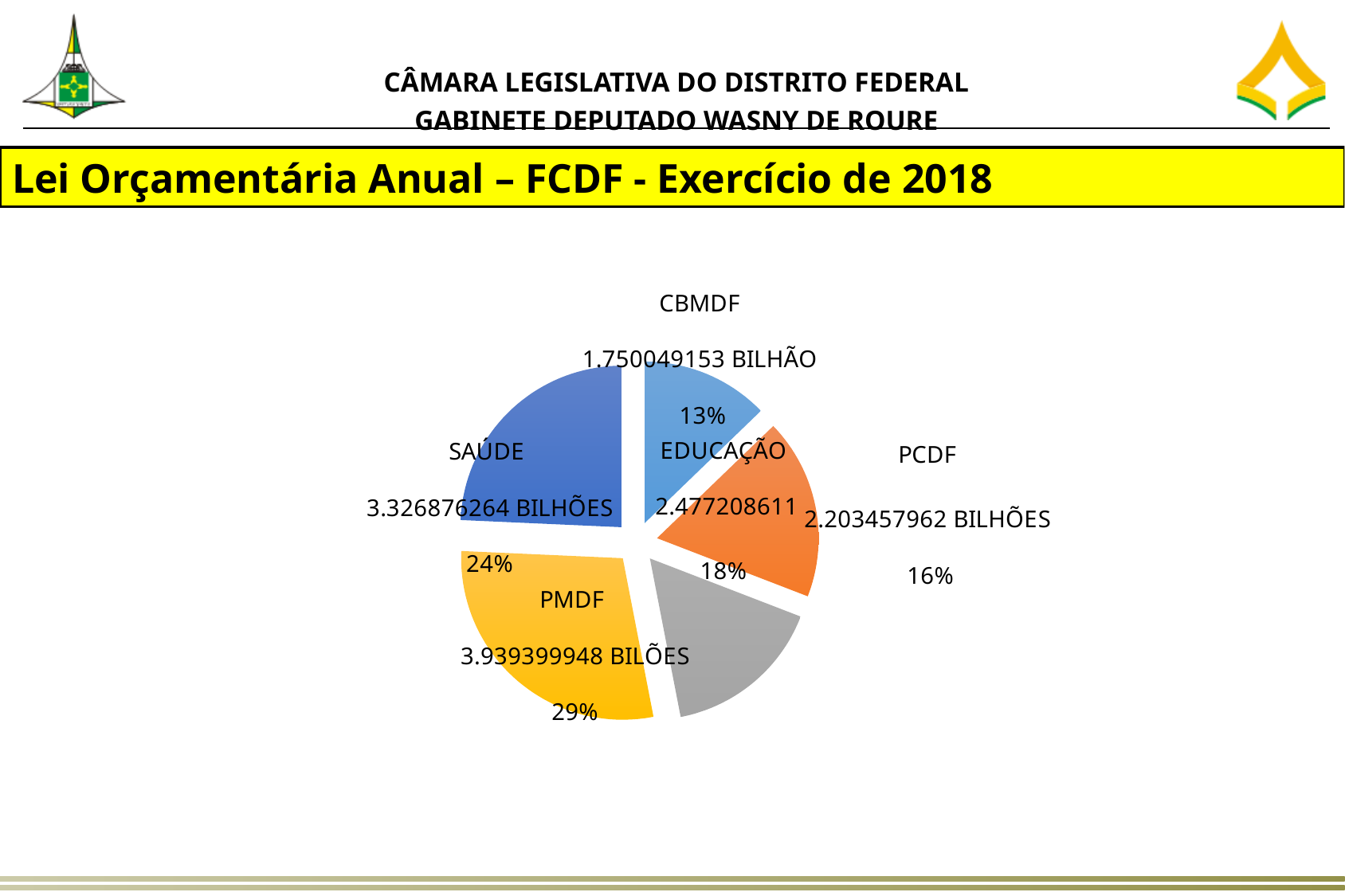
Which category has the largest share of the pie chart? PMDF What kind of chart is shown on the slide? pie chart What is the difference in percentage points between the shares of PMDF and SAÚDE? 5 What percentage share does PMDF have in the pie chart? 29% What percentage share does SAÚDE have in the pie chart? 24% How many slices does the pie chart have? 5 What value is shown for CBMDF in the pie chart? 1.750049153 BILHÃO What percentage share does CBMDF have in the pie chart? 13% What value is shown for SAÚDE in the pie chart? 3.326876264 BILHÕES What value is shown for PCDF in the pie chart? 2.203457962 BILHÕES Which category has the smallest share of the pie chart? CBMDF Which has a larger share of the pie chart, EDUCAÇÃO or PCDF? EDUCAÇÃO